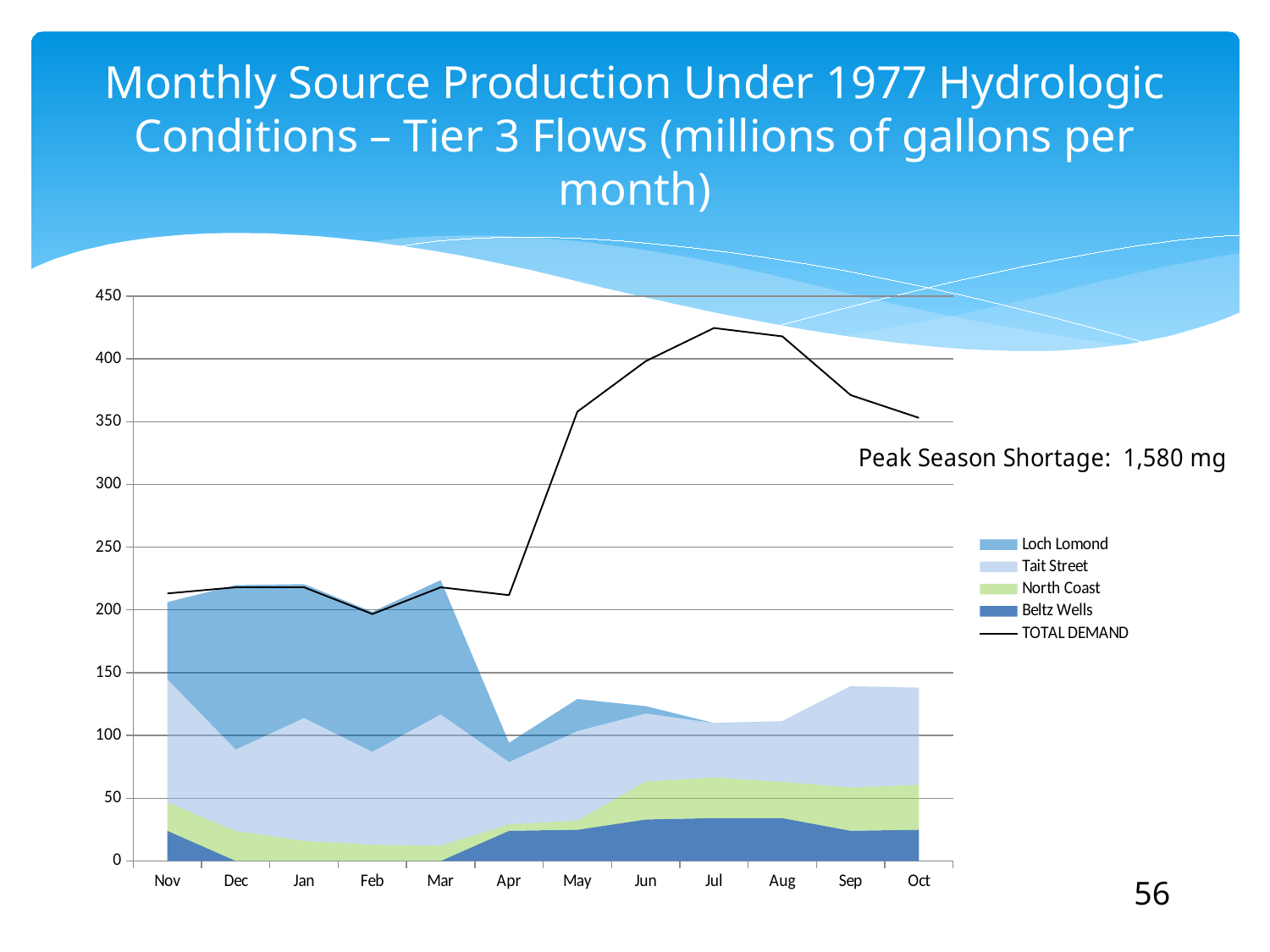
In which month is TOTAL DEMAND lowest? Feb Does TOTAL DEMAND rise or fall from Apr to Jul? rise Is the total stacked production in Oct greater or less than 150? less How many months are shown along the x axis? 12 In which month is TOTAL DEMAND highest? Jul Is TOTAL DEMAND in Sep greater or less than 350? greater What kind of chart is shown on the slide? Stacked area chart with a line Is TOTAL DEMAND in Jul greater or less than 400? greater How many series does the legend list? 5 What Peak Season Shortage value is stated on the slide? 1,580 mg Does TOTAL DEMAND rise or fall from Jul to Oct? fall